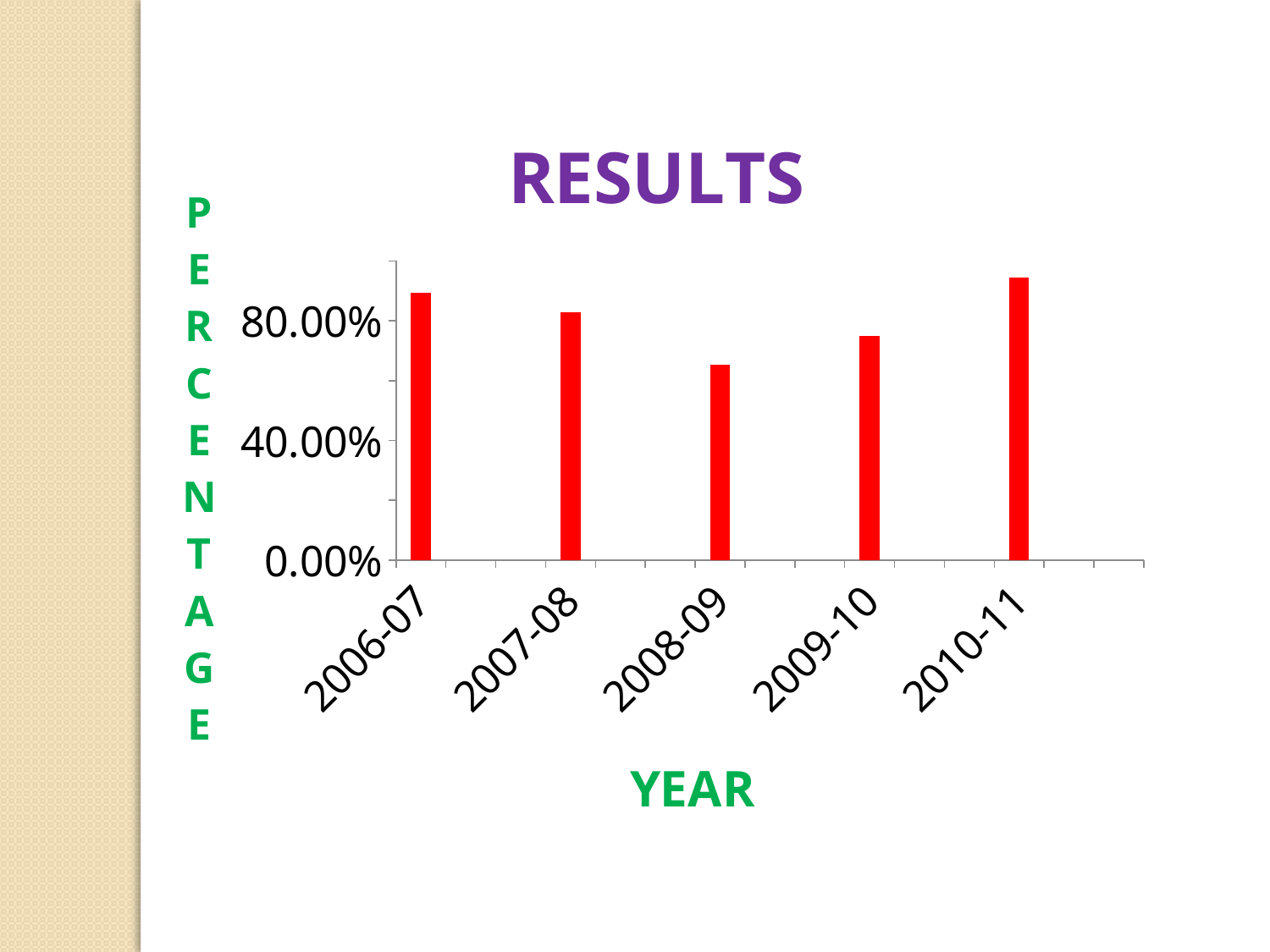
What is the title of the chart? RESULTS Which year has the highest percentage in the RESULTS chart? 2010-11 How many years are shown on the x axis of the RESULTS chart? 5 Is the value for 2009-10 greater or less than 40.00%? greater Which year has the larger value, 2007-08 or 2009-10? 2007-08 Is the value for 2010-11 greater or less than 80.00%? greater Which year has the lowest percentage in the RESULTS chart? 2008-09 What is the label of the x axis? YEAR Is the value for 2006-07 greater or less than 80.00%? greater What kind of chart is shown on the slide? bar chart Do the values rise or fall from 2006-07 to 2008-09? fall